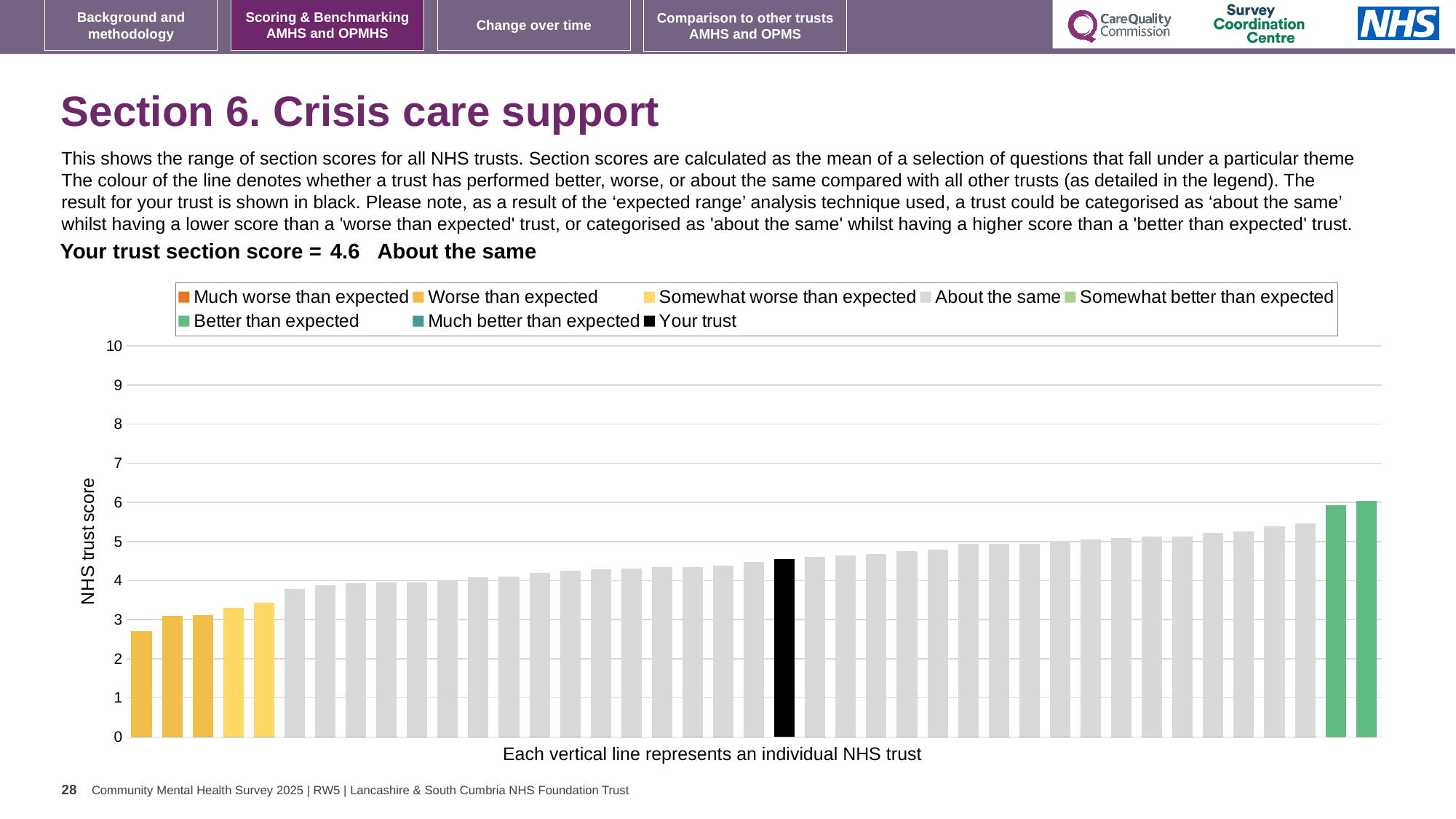
What is the section score for your trust shown on the slide? 4.6 How many entries does the chart legend list? 8 How many bars are coloured green ('Better than expected')? 2 Which legend category is your trust placed in for this section? About the same Which legend category does the highest bar on the chart belong to? Better than expected Is the value of the rightmost (highest) bar greater or less than 5? greater Do the bar values rise or fall from left to right along the x axis? Rise What type of chart is shown on the slide? Bar chart What is the label on the y axis of the chart? NHS trust score Is the value of the black 'Your trust' bar greater or less than 4? greater How many bars are coloured in the 'Worse than expected' colour? 3 Is the value of the leftmost (lowest) bar greater or less than 3? less